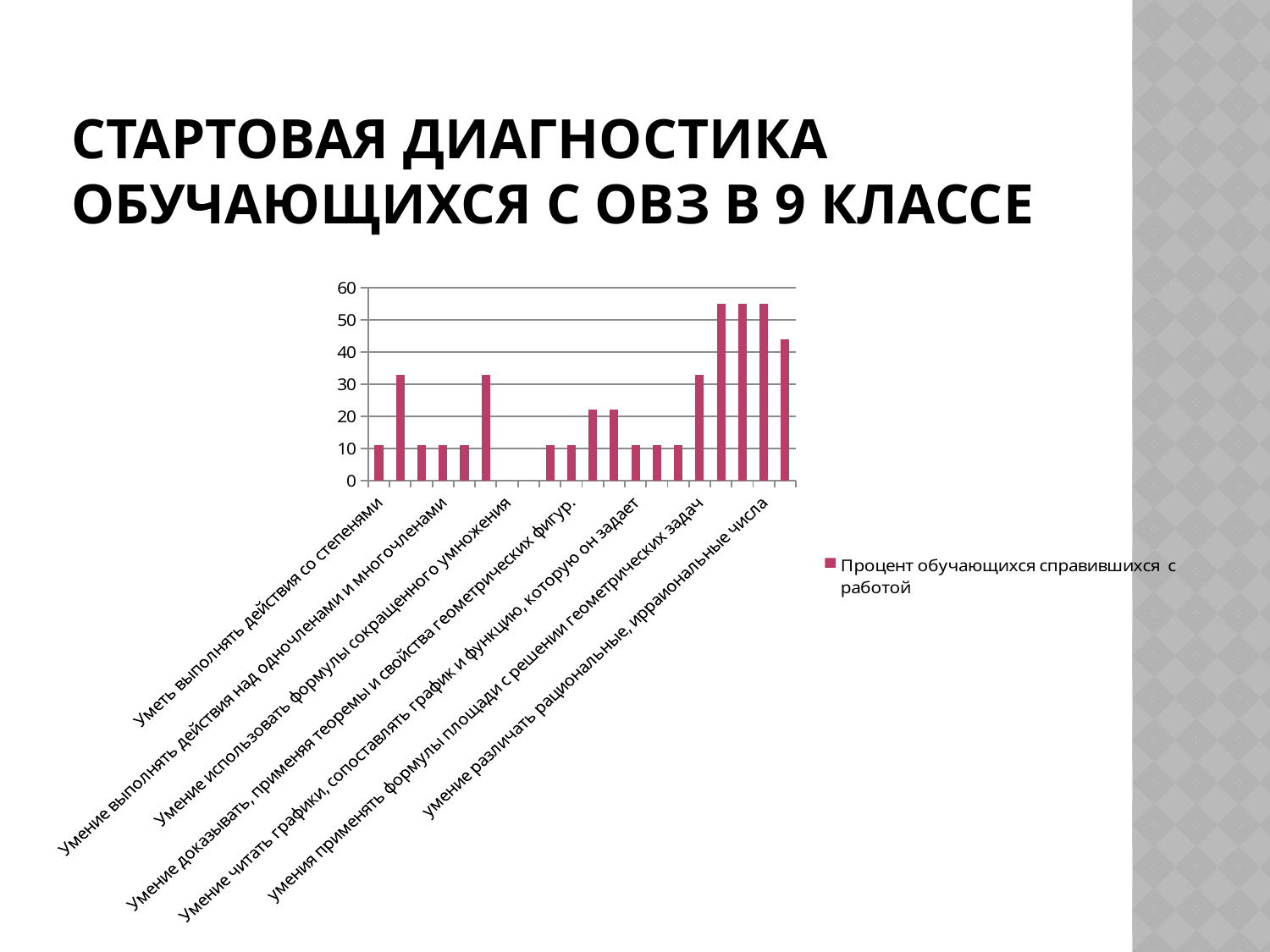
Which is taller, the first bar on the left or the last bar on the right? the last bar on the right Do the bars at the right end of the chart generally sit higher or lower than the bars at the left end? higher What is the title of the slide containing the chart? Стартовая диагностика обучающихся с ОВЗ в 9 классе What is the highest value shown on the vertical axis? 60 Is the first bar on the left greater or less than 20? less Is the tallest bar in the chart greater or less than 50? greater What is the name of the series shown in the legend? Процент обучающихся справившихся с работой What kind of chart is shown on the slide? bar chart How many bars in the chart rise above the 50 gridline? 3 Is the tallest bar in the chart greater or less than 60? less How many series does the legend list? 1